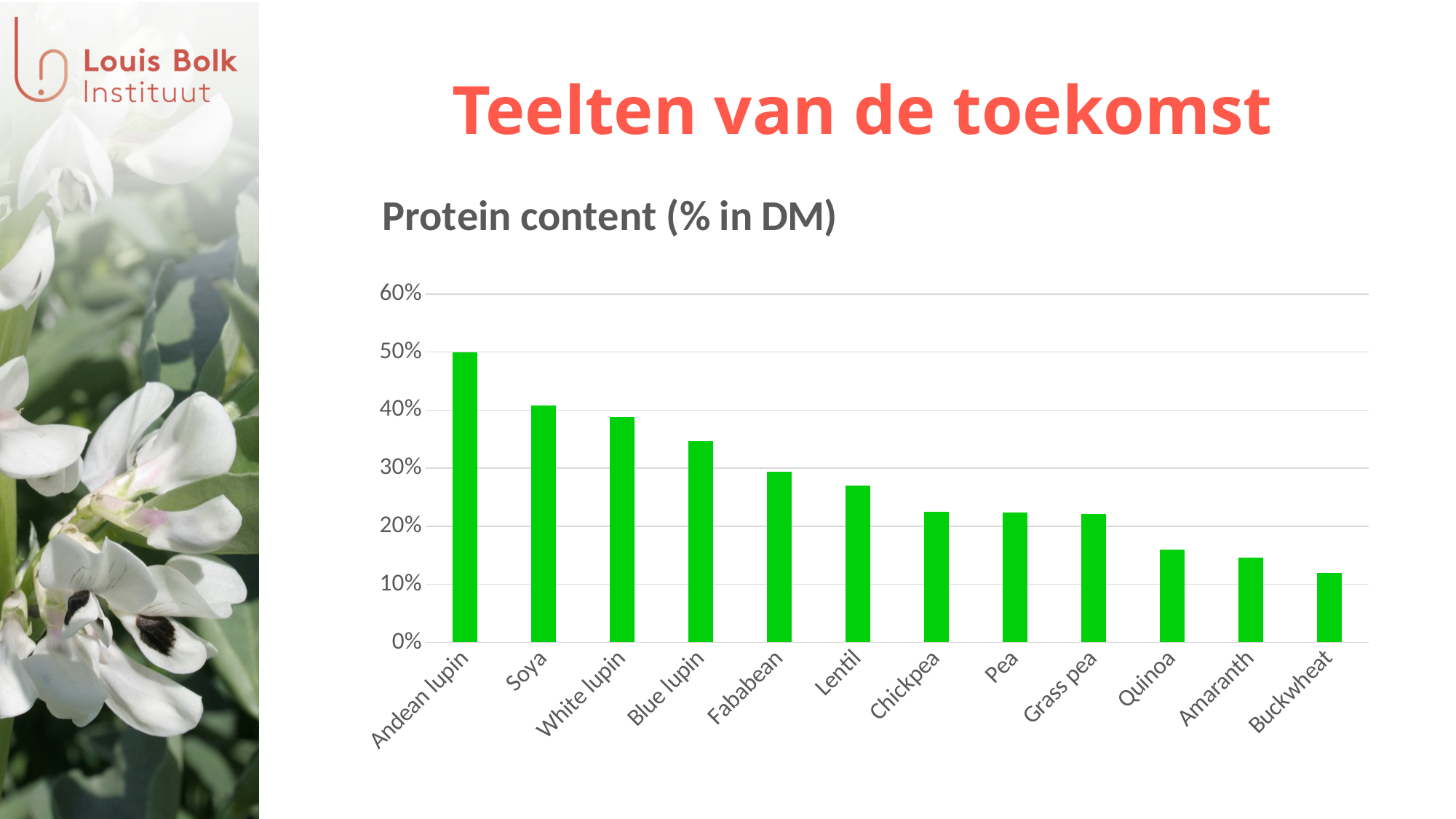
How many crops are shown on the x axis of the chart? 12 Which crop has the lowest protein content? Buckwheat Is the value for White lupin greater or less than 40%? less Is the value for Blue lupin greater or less than 30%? greater What is the title of the chart? Protein content (% in DM) Is the value for Lentil greater or less than 30%? less Which crop has the highest protein content? Andean lupin Do the values rise or fall from left to right along the x axis? fall Which has a higher protein content, Soya or Lentil? Soya What kind of chart is shown on the slide? bar chart